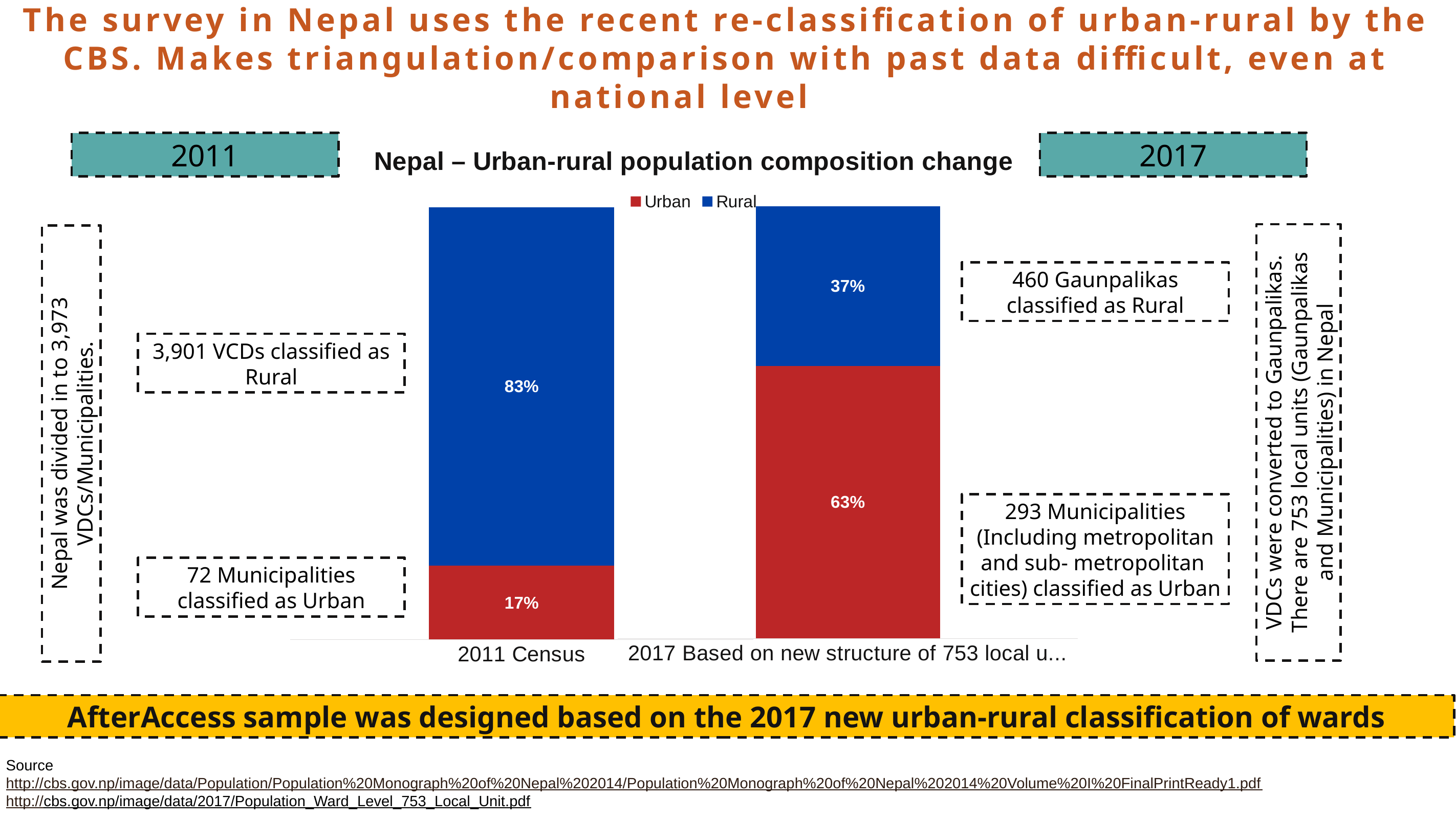
Which category has the lower Rural share? 2017 How many series does the legend list? 2 What is the Rural share in the 2017 bar? 37% What is the Urban share in the 2011 Census bar? 17% What is the title of the chart? Nepal – Urban-rural population composition change What is the Urban share in the 2017 bar? 63% What is the total of the stacked bar for the 2011 Census? 100% What is the difference between the Rural share in 2011 and the Rural share in 2017? 46% What is the Rural share in the 2011 Census bar? 83% What is the difference between the Urban share in 2017 and the Urban share in 2011? 46% Which category has the higher Urban share, 2011 Census or 2017? 2017 What kind of chart is shown? Stacked bar chart